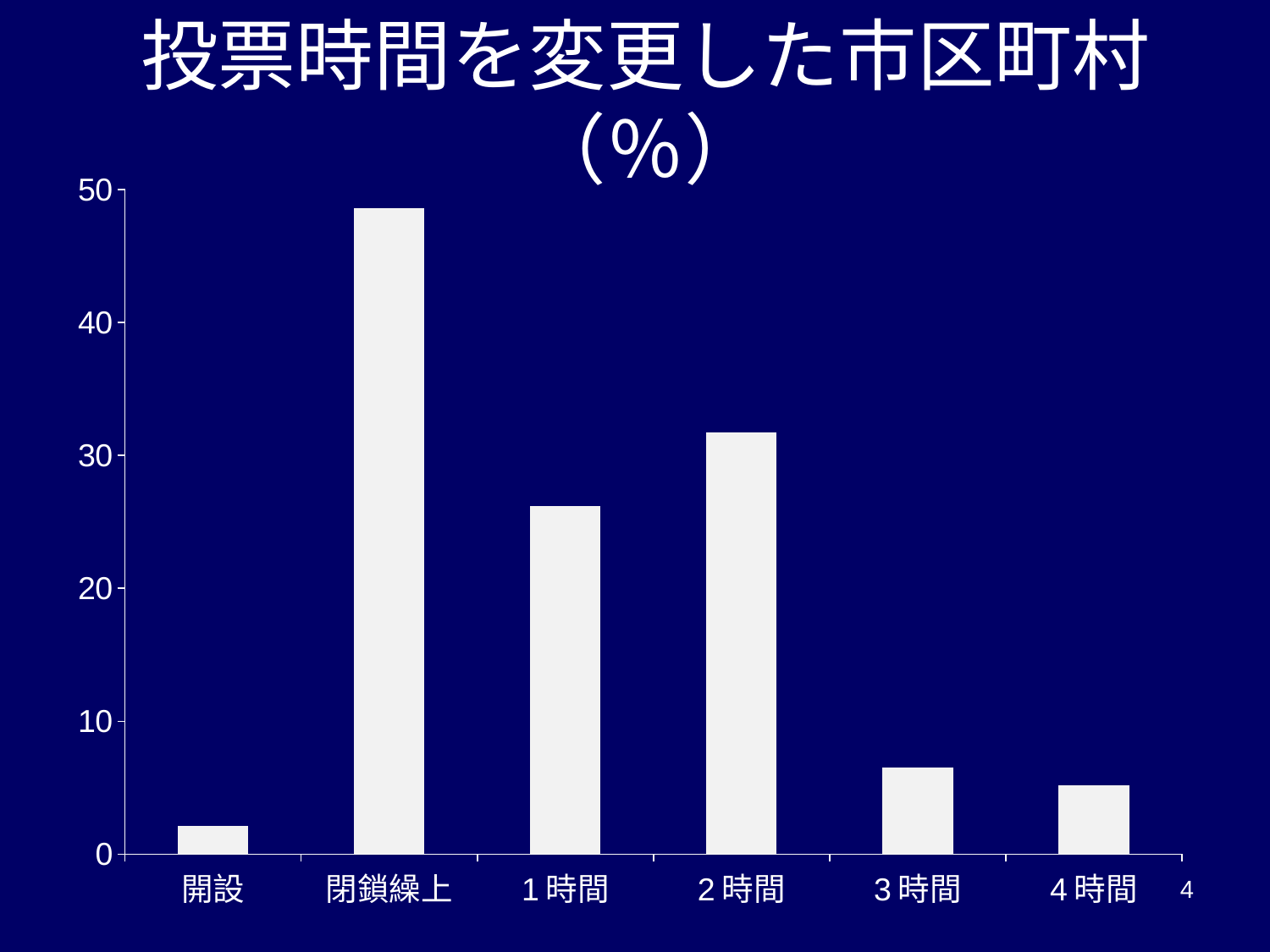
Which category has the highest value in the chart? 閉鎖繰上 Which is larger, the value for 1時間 or the value for 2時間? 2時間 Which category has the lowest value in the chart? 開設 Which is larger, the value for 3時間 or the value for 4時間? 3時間 Is the value for 3時間 greater or less than 10? less Is the value for 2時間 greater or less than 30? greater What kind of chart is shown on the slide? bar chart How many categories are shown on the x axis of the chart? 6 Is the value for 開設 greater or less than 10? less What is the title of the chart on the slide? 投票時間を変更した市区町村（%）